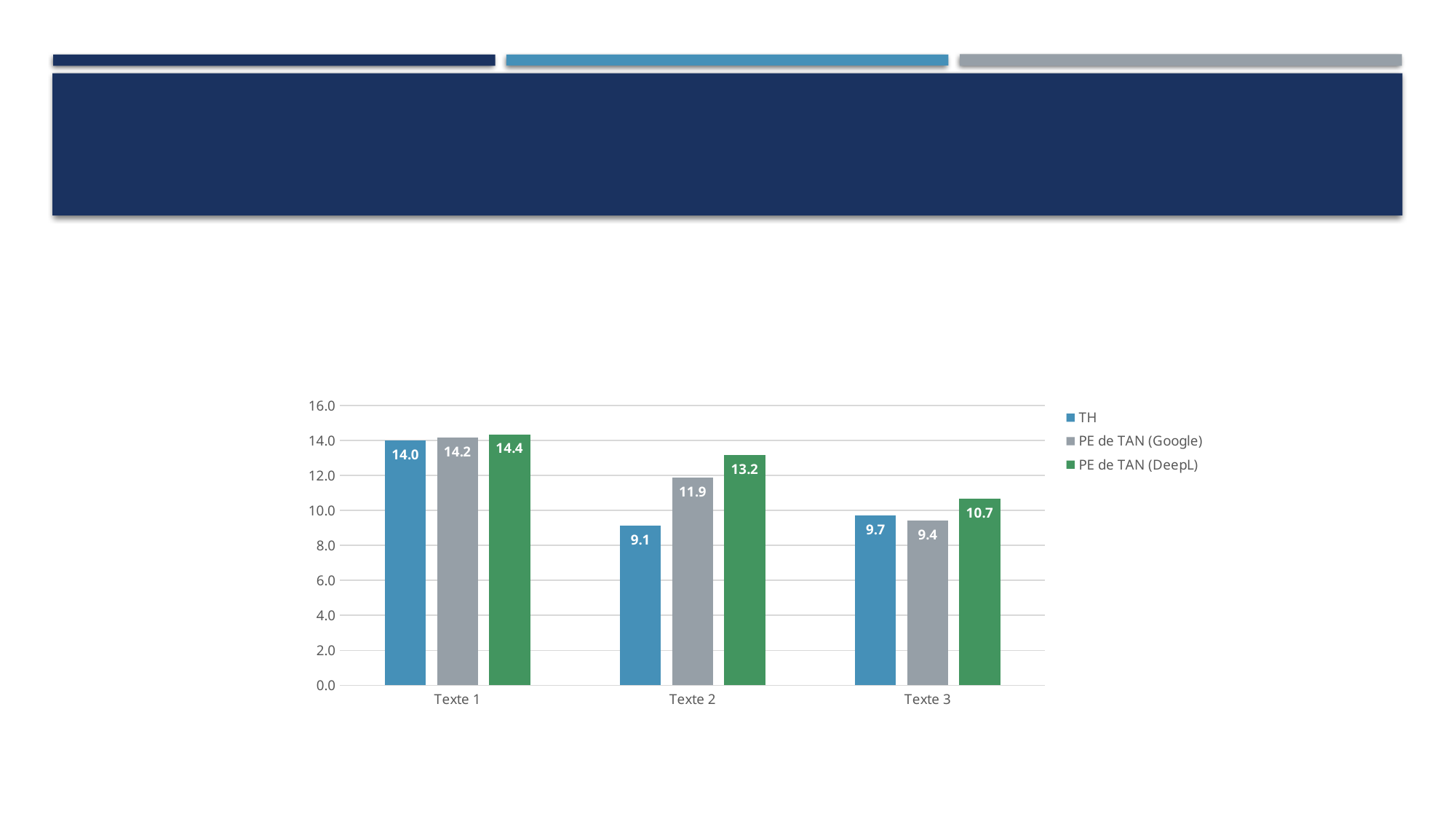
For Texte 3, which is larger: TH or PE de TAN (DeepL)? PE de TAN (DeepL) What is the value for PE de TAN (DeepL) for Texte 2? 13.2 Is the value for PE de TAN (Google) for Texte 2 greater or less than 10.0? greater How many series does the legend list? 3 What kind of chart is shown on the slide? bar chart Which category has the highest value for PE de TAN (DeepL)? Texte 1 What is the value for PE de TAN (Google) for Texte 3? 9.4 What colour are the bars for the PE de TAN (DeepL) series? green What is the value for TH for Texte 1? 14.0 How many categories are shown on the x axis? 3 Which category has the lowest value for TH? Texte 2 What is the difference between PE de TAN (DeepL) and TH for Texte 2? 4.1